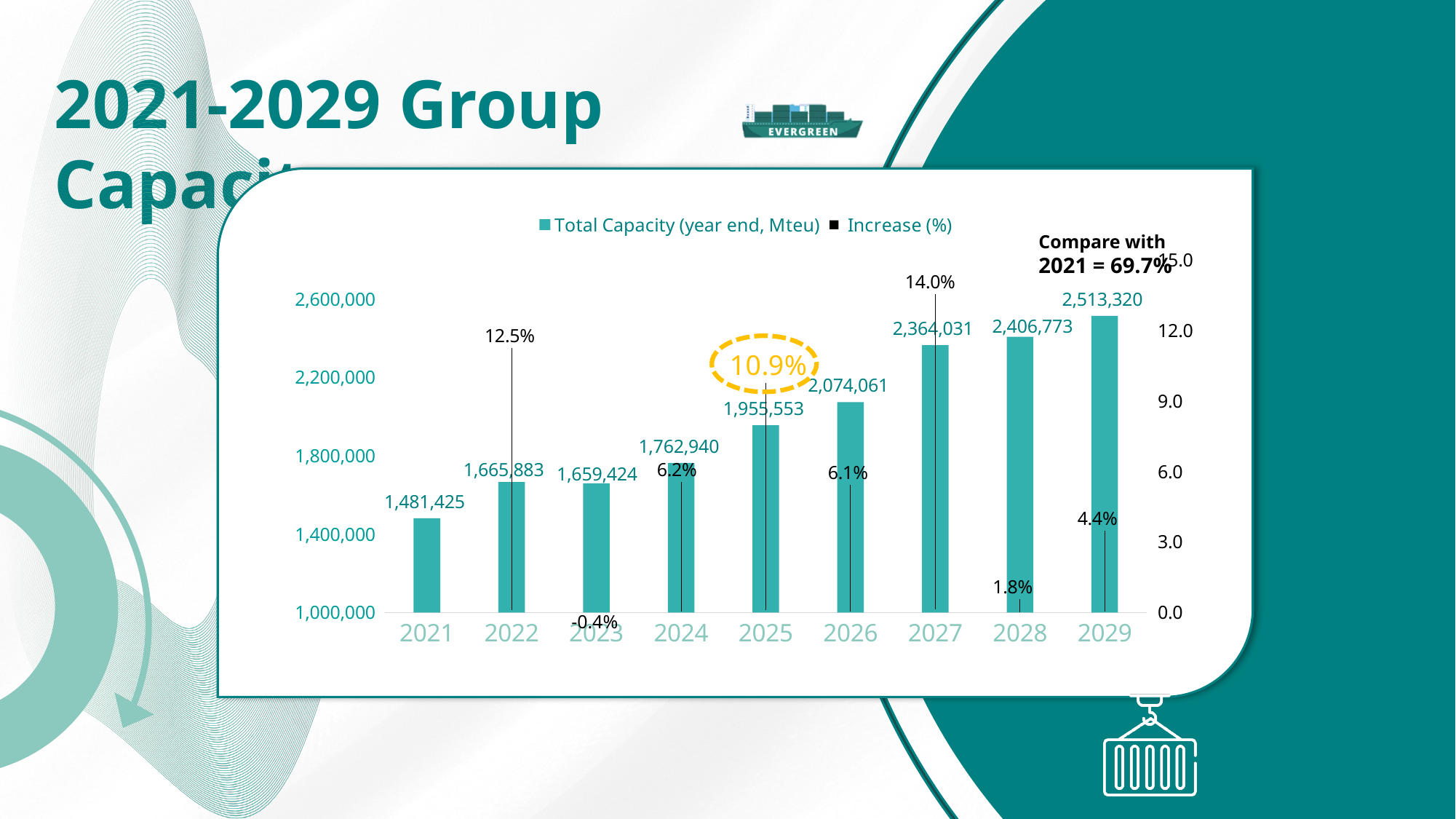
How many series does the legend list? 2 What kind of chart is used to show Total Capacity (year end, Mteu)? Bar chart Which year has the highest Total Capacity (year end, Mteu)? 2029 What is the difference in Total Capacity between 2029 and 2021? 1,031,895 Which year has the larger Total Capacity, 2022 or 2023? 2022 What is the Increase (%) shown for 2027? 14.0% Which Increase (%) value is circled in yellow on the chart? 10.9% What is the Increase (%) shown for 2023? -0.4% How many years are shown on the x axis? 9 What is the Total Capacity (year end, Mteu) for 2029? 2,513,320 What is the Total Capacity (year end, Mteu) for 2021? 1,481,425 Which year has the lowest Increase (%)? 2023